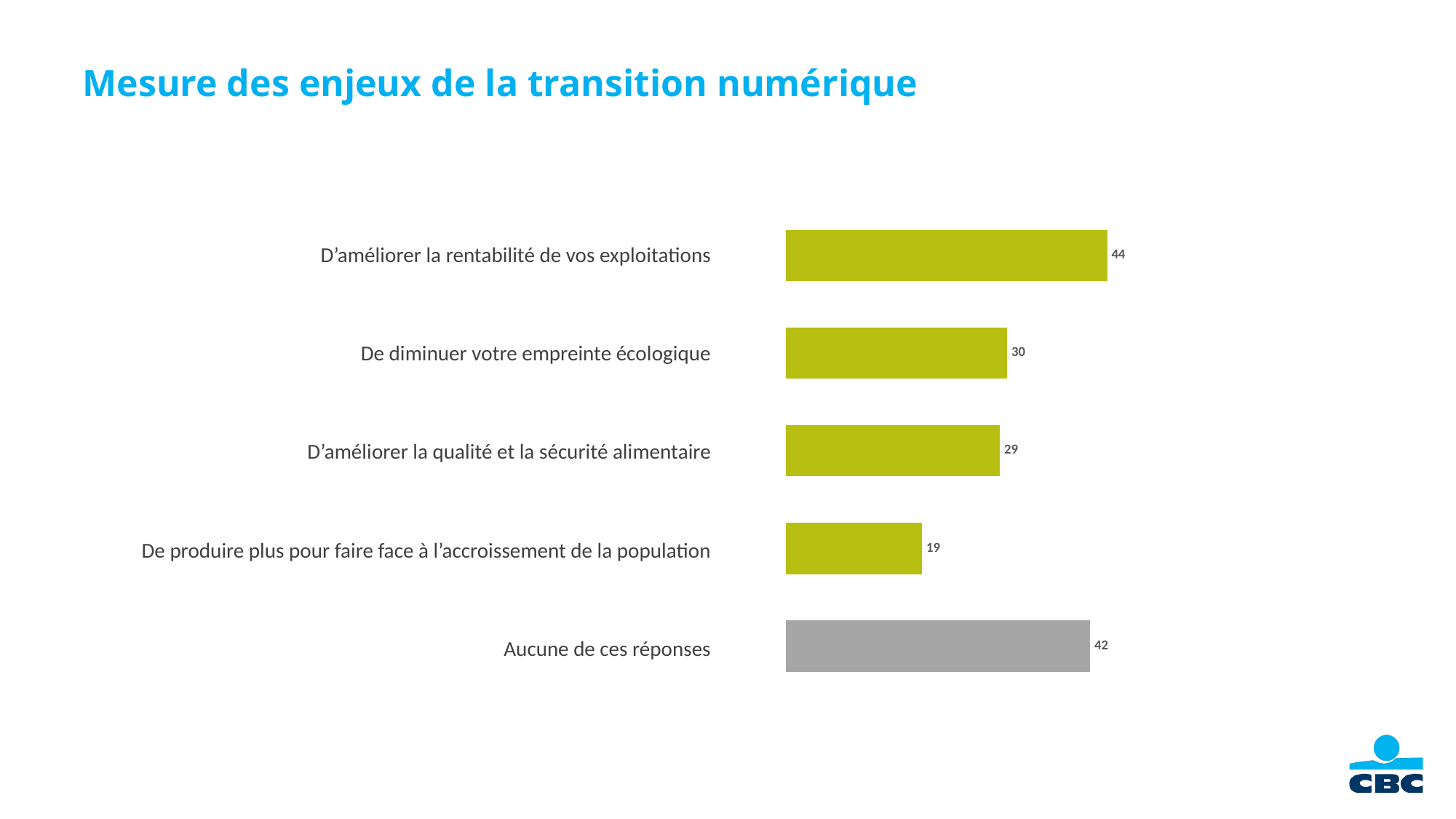
Which category has the highest value? D'améliorer la rentabilité de vos exploitations Which bar is coloured grey instead of green? Aucune de ces réponses How many categories are shown in the chart? 5 What is the difference between the values for "De diminuer votre empreinte écologique" and "De produire plus pour faire face à l'accroissement de la population"? 11 Which is larger: the value for "De diminuer votre empreinte écologique" or for "D'améliorer la qualité et la sécurité alimentaire"? De diminuer votre empreinte écologique What is the difference between the values for "D'améliorer la rentabilité de vos exploitations" and "Aucune de ces réponses"? 2 Which category has the lowest value? De produire plus pour faire face à l'accroissement de la population What is the value for "De diminuer votre empreinte écologique"? 30 What kind of chart is shown on the slide? Bar chart What is the value for "De produire plus pour faire face à l'accroissement de la population"? 19 What is the value for "D'améliorer la rentabilité de vos exploitations"? 44 What is the value for "Aucune de ces réponses"? 42